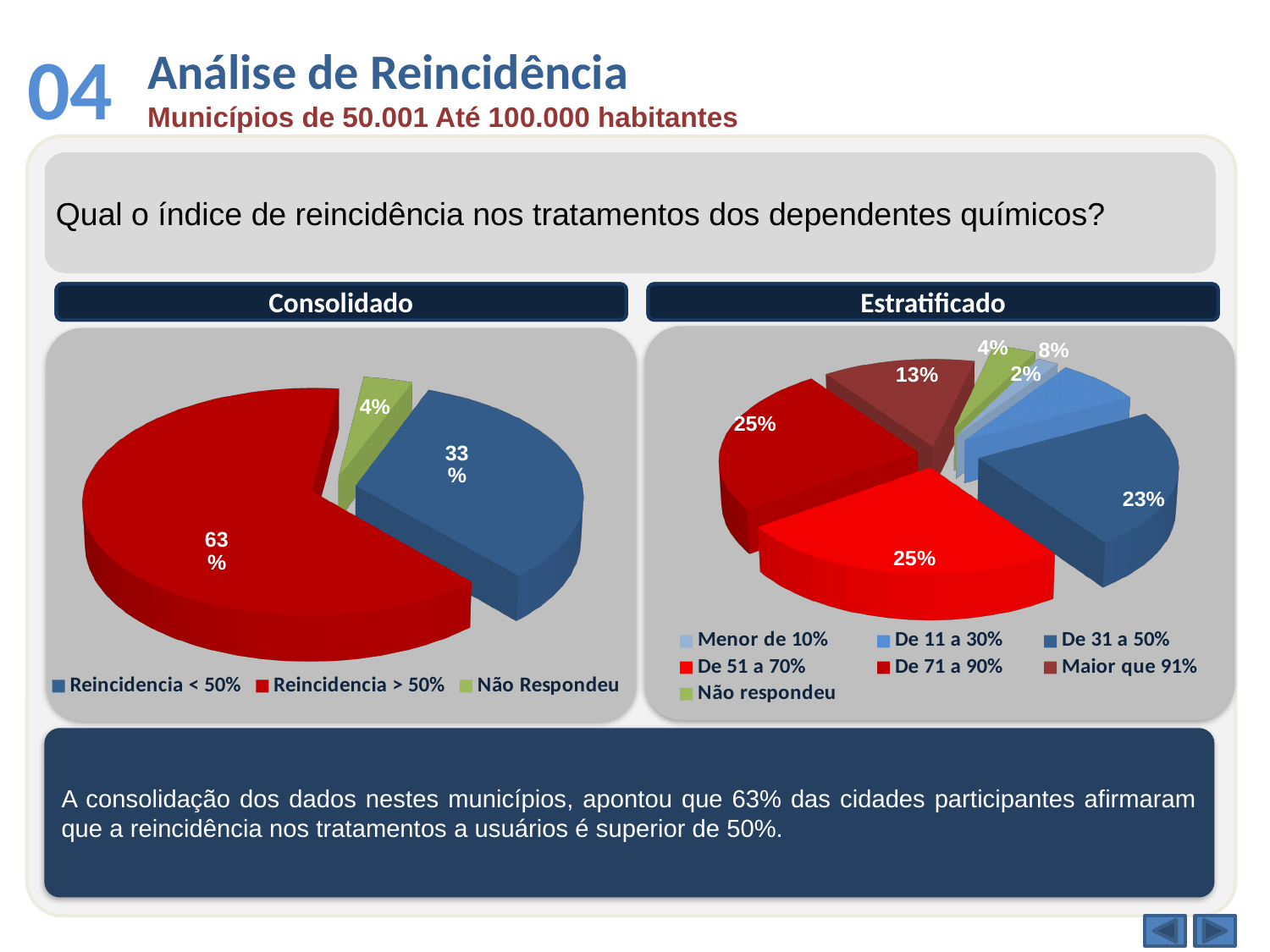
In the Estratificado chart, what is the value for De 31 a 50%? 23% In the Consolidado chart, what is the value for Reincidencia > 50%? 63% How many categories does the Consolidado chart show? 3 In the Consolidado chart, what is the value for Reincidencia < 50%? 33% In the Consolidado chart, which category has the smallest slice? Não Respondeu In the Estratificado chart, what is the value for Maior que 91%? 13% How many categories does the legend of the Estratificado chart list? 7 In the Estratificado chart, what is the difference between De 31 a 50% and De 11 a 30%? 15% In the Estratificado chart, which category has the smallest slice? Menor de 10% What kind of chart is the Consolidado chart? Pie chart In the Consolidado chart, what is the difference between Reincidencia > 50% and Reincidencia < 50%? 30% In the Estratificado chart, which is larger: De 11 a 30% or De 31 a 50%? De 31 a 50%